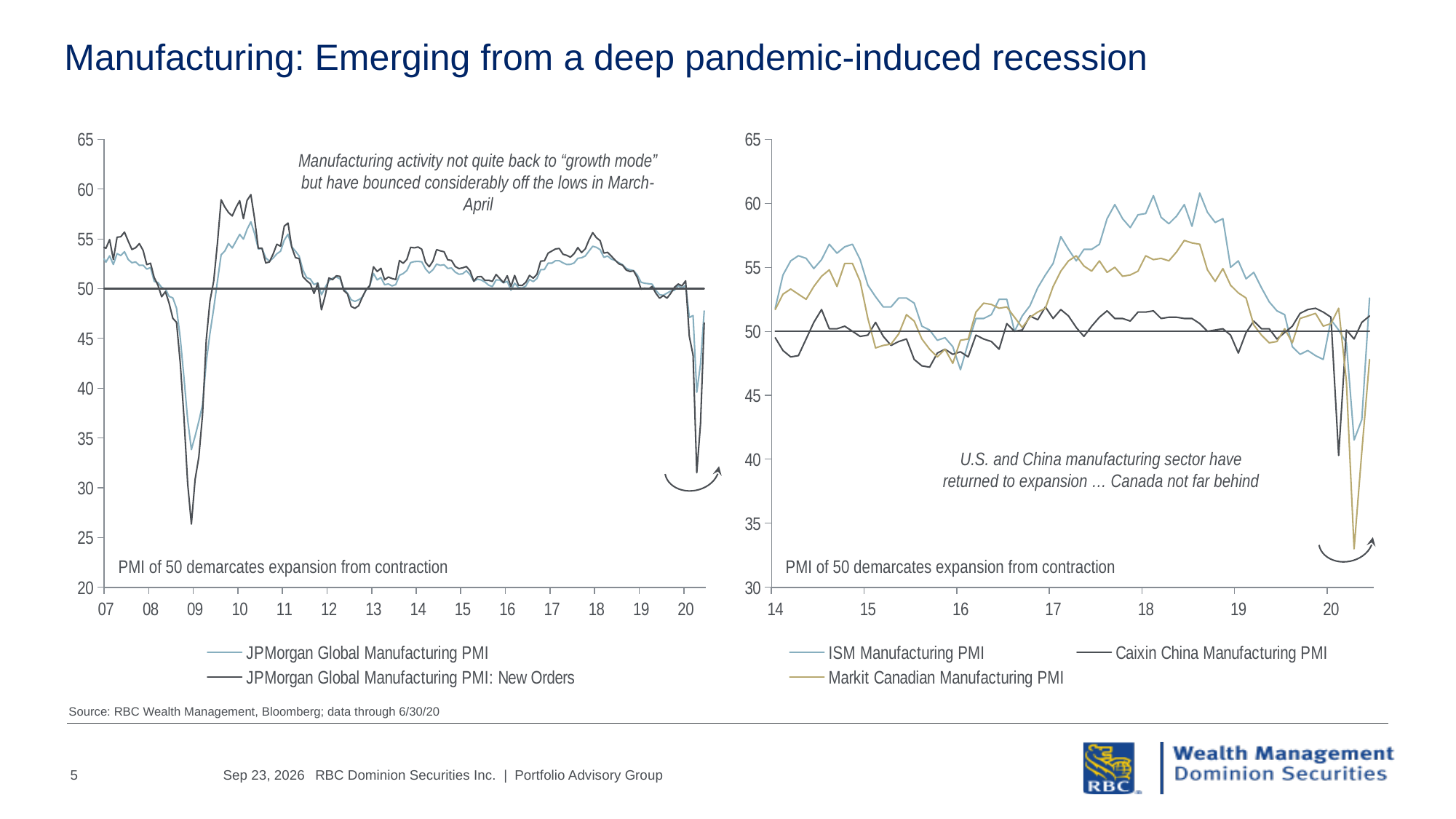
In the right chart, is the lowest value of the Markit Canadian Manufacturing PMI in 2020 greater or less than 35? less In the right chart, is the lowest value of the Caixin China Manufacturing PMI in 2020 greater or less than 45? less In the left chart, which series reached the lower value during the 2009 trough: JPMorgan Global Manufacturing PMI or JPMorgan Global Manufacturing PMI: New Orders? JPMorgan Global Manufacturing PMI: New Orders In the right chart, which series fell to the lowest value in 2020? Markit Canadian Manufacturing PMI How many series does the legend of the right chart list? 3 What kind of chart is the right chart (ISM / Caixin / Markit PMIs)? line chart According to the note on both charts, what PMI level demarcates expansion from contraction? 50 In the left chart, is the lowest value of the JPMorgan Global Manufacturing PMI: New Orders series (around 2009) greater or less than 30? less How many series does the legend of the left chart list? 2 What kind of chart is the left chart (JPMorgan Global Manufacturing PMI)? line chart